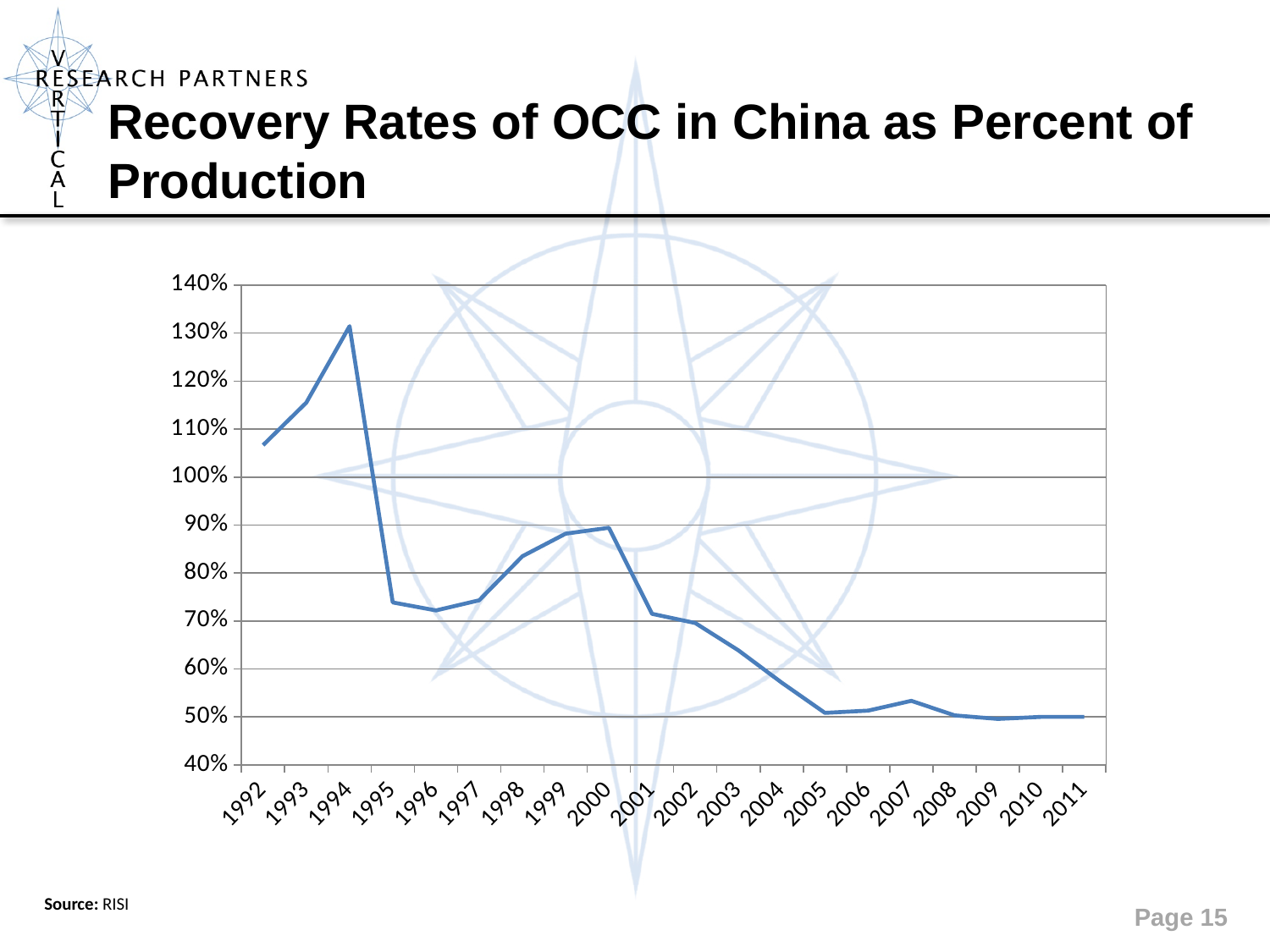
In which year is the recovery rate of OCC in China highest? 1994 Is the value for 2000 greater or less than 80%? greater How many years are plotted along the x axis of the chart? 20 Is the value for 2005 greater or less than 60%? less Which year has the larger recovery rate, 1999 or 2001? 1999 Overall, does the recovery rate rise or fall from 1992 to 2011? fall What kind of chart is shown on the slide? line chart Is the value for 1994 greater or less than 120%? greater Which year has the larger recovery rate, 1994 or 1995? 1994 What is the title of the chart on the slide? Recovery Rates of OCC in China as Percent of Production